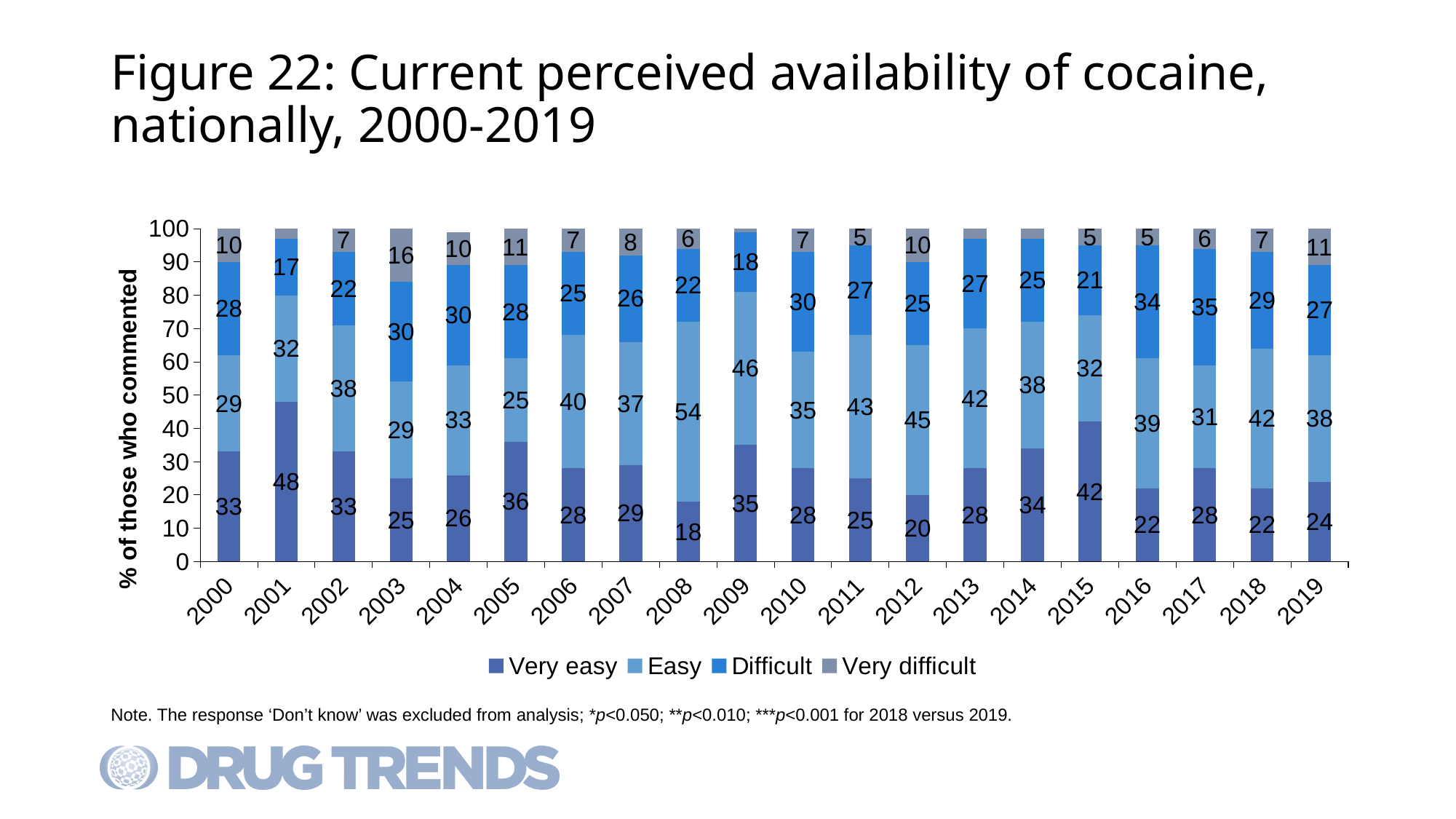
Which year has the highest 'Very easy' value? 2001 Which year has the lowest 'Very easy' value? 2008 What is the difference between the 'Very easy' values for 2001 and 2008? 30 What is the 'Very difficult' value for 2019? 11 How many years are shown along the x axis? 20 Which is larger, the 'Very easy' value for 2015 or for 2019? 2015 Which year has the highest 'Very difficult' value? 2003 How many series does the legend list? 4 What is the total of the stacked bar for 2000? 100 What kind of chart is shown on the slide? Stacked bar chart What is the 'Easy' value for 2008? 54 What is the 'Very easy' value for 2001? 48